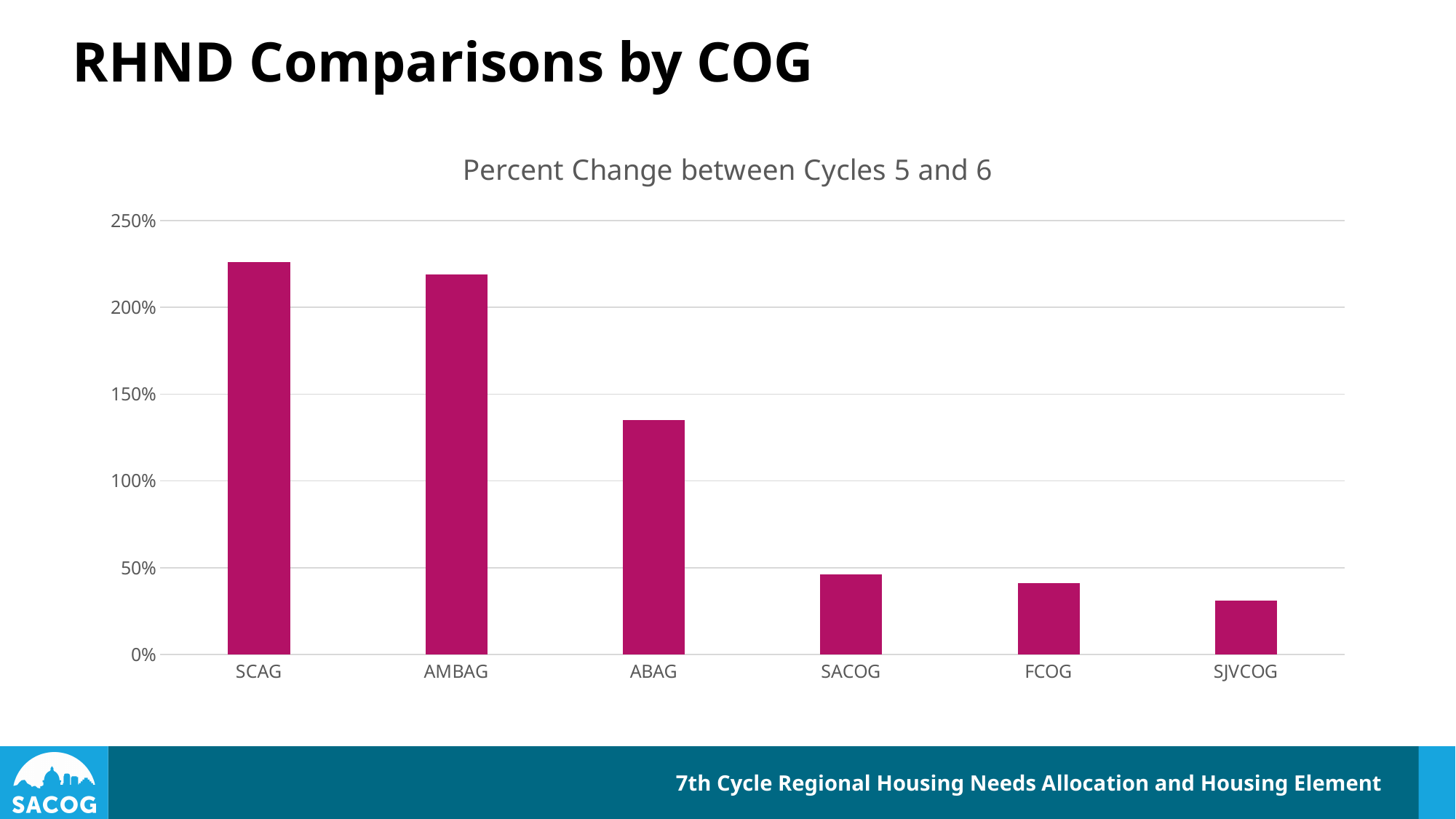
What type of chart is shown on the slide? Bar chart Is the percent change for ABAG greater or less than 100%? greater Which COG has the lowest percent change between Cycles 5 and 6? SJVCOG Is the percent change for SJVCOG greater or less than 50%? less Do the values rise or fall moving from left to right along the x axis? Fall How many COGs are shown on the x axis of the chart? 6 Which has a larger percent change, ABAG or SACOG? ABAG What is the title of the chart? Percent Change between Cycles 5 and 6 Is the percent change for SCAG greater or less than 200%? greater Which COG has the highest percent change between Cycles 5 and 6? SCAG Which has a larger percent change, AMBAG or ABAG? AMBAG